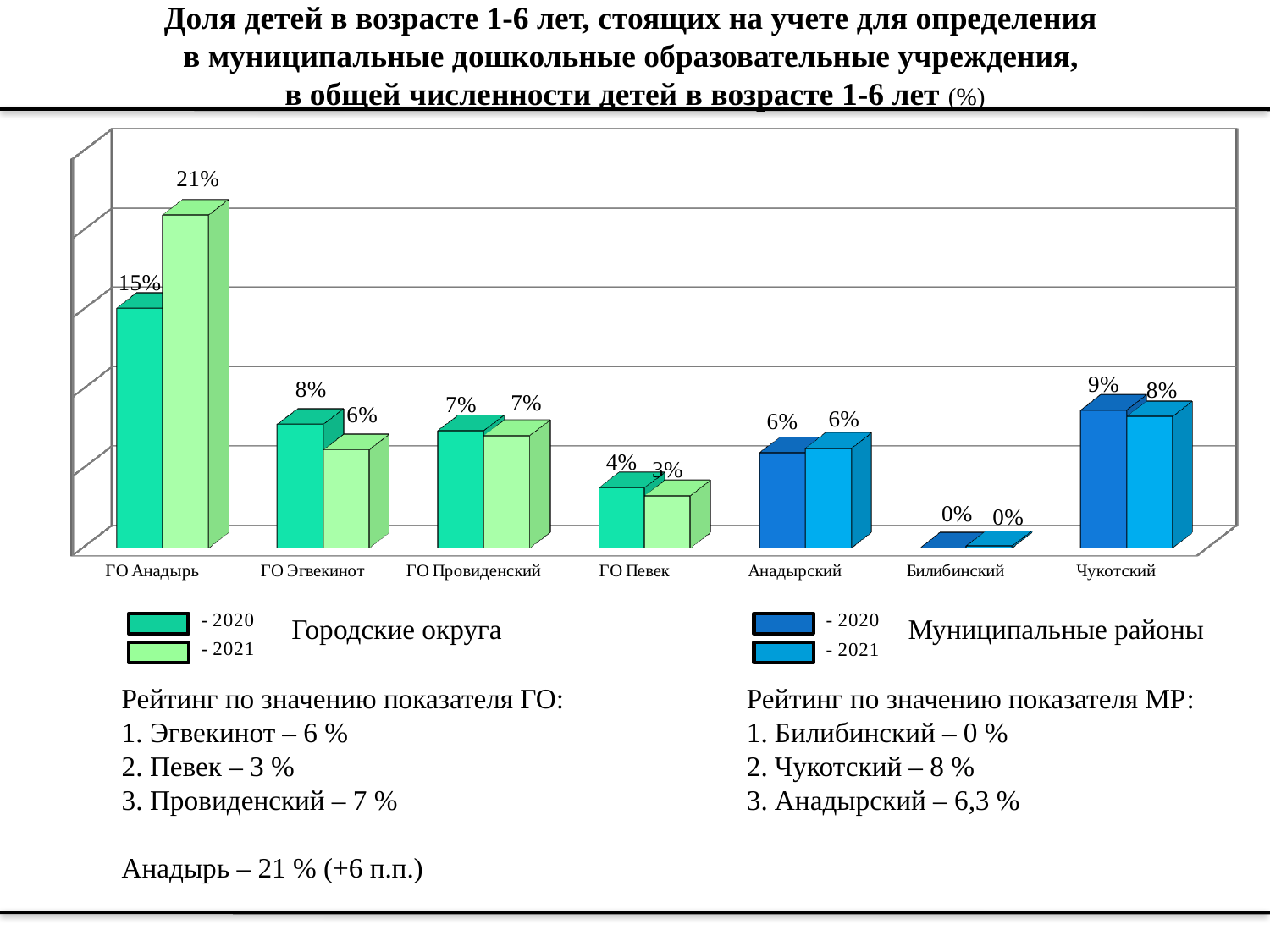
What kind of chart is shown on the slide? Bar chart How many categories are shown on the x axis? 7 Which category has the highest 2021 value? ГО Анадырь What is the 2021 value for Чукотский? 8% Which category has the lowest 2020 value? Билибинский Which is larger: the 2020 value for Чукотский or the 2020 value for Анадырский? Чукотский What is the 2020 value for ГО Эгвекинот? 8% What is the 2020 value for ГО Певек? 4% Did the value for ГО Певек rise or fall from 2020 to 2021? Fall What is the 2021 value for ГО Анадырь? 21% Which two years are listed in the legend for Городские округа? 2020 and 2021 What is the difference between the 2021 and 2020 values for ГО Анадырь? 6 percentage points